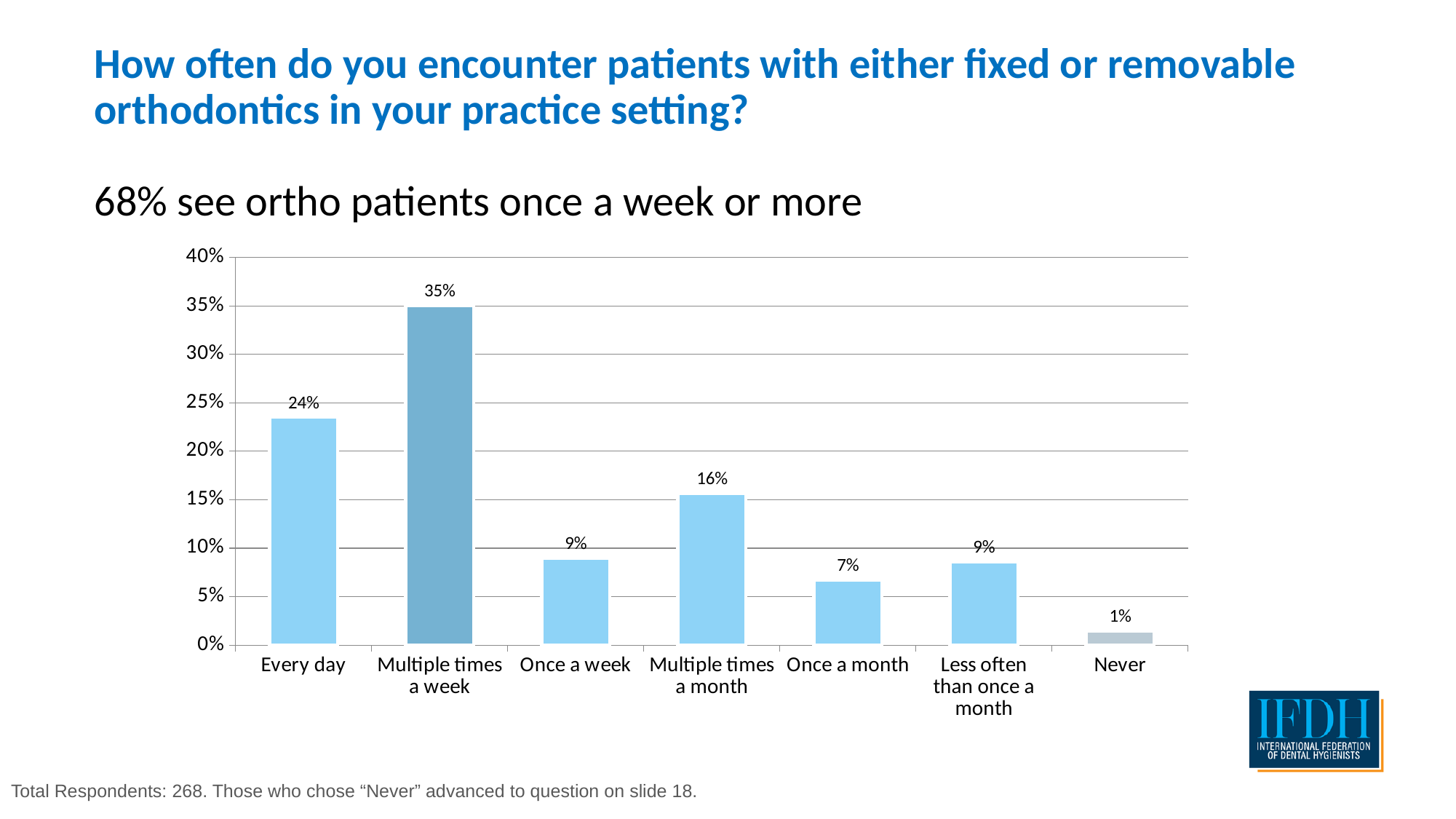
Is the value for 'Every day' greater or less than 20%? greater Which category has the highest percentage? Multiple times a week What is the difference between 'Multiple times a week' and 'Every day'? 11% Which bar is shaded a darker blue than the others? Multiple times a week Which category has the lowest percentage? Never How many categories are shown on the x axis? 7 What kind of chart is shown on the slide? Bar chart What percentage of respondents encounter orthodontic patients every day? 24% What percentage of respondents chose 'Never'? 1% What percentage of respondents chose 'Multiple times a week'? 35% What is the value for 'Multiple times a month'? 16% Which is larger: 'Multiple times a month' or 'Once a month'? Multiple times a month